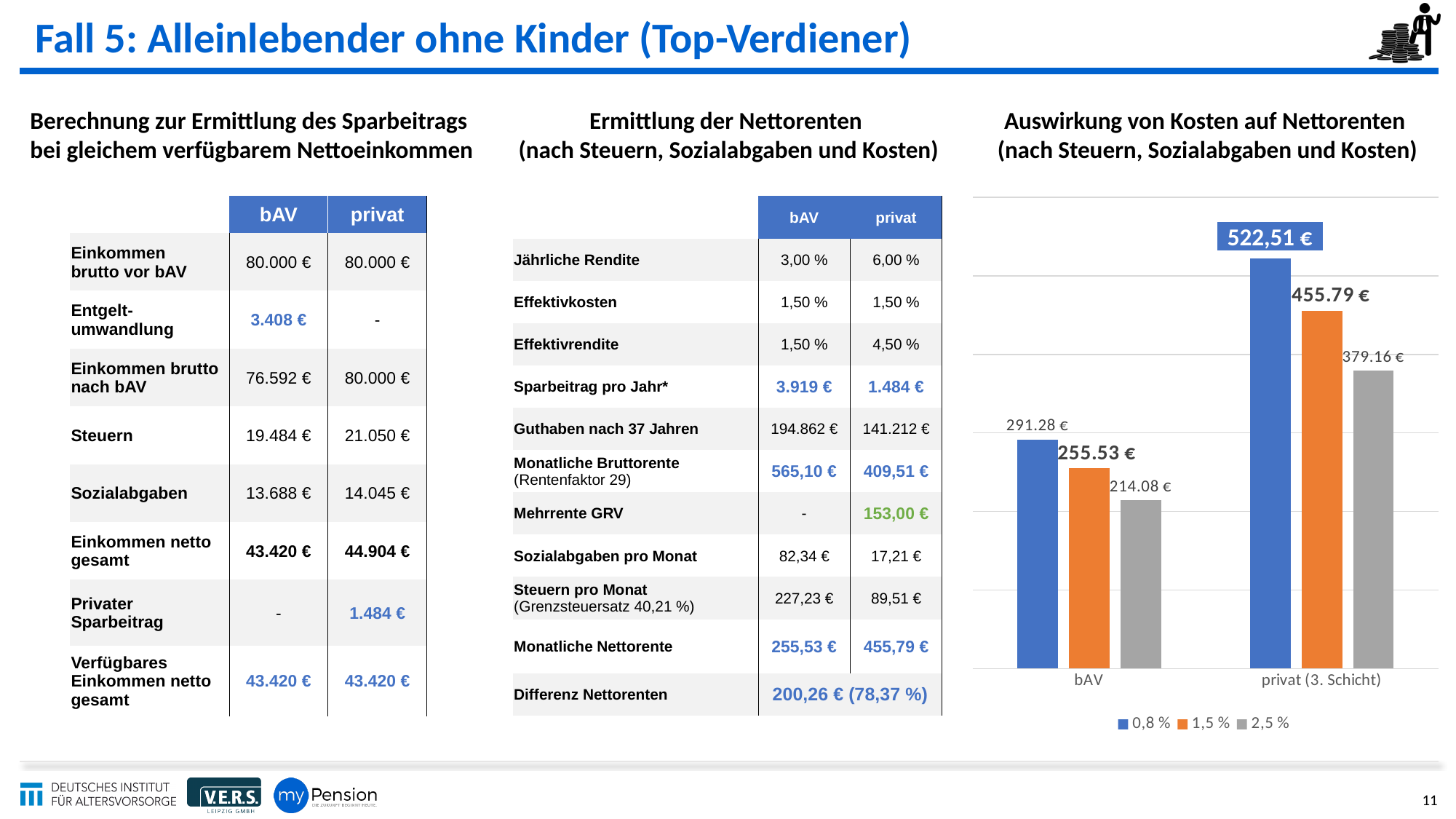
In the chart 'Auswirkung von Kosten auf Nettorenten', what is the value of the 1,5 % series for privat (3. Schicht)? 455.79 € In the chart 'Auswirkung von Kosten auf Nettorenten', which is larger: the 2,5 % value for privat (3. Schicht) or the 0,8 % value for bAV? 2,5 % value for privat (3. Schicht) How many categories are shown on the x axis of the chart 'Auswirkung von Kosten auf Nettorenten'? 2 In the chart 'Auswirkung von Kosten auf Nettorenten', what is the difference between the 1,5 % values for privat (3. Schicht) and bAV? 200.26 € How many series does the legend of the chart 'Auswirkung von Kosten auf Nettorenten' list? 3 In the chart 'Auswirkung von Kosten auf Nettorenten', which bar has the highest value? privat (3. Schicht), 0,8 % In the chart 'Auswirkung von Kosten auf Nettorenten', what is the value of the 0,8 % series for bAV? 291.28 € In the chart 'Auswirkung von Kosten auf Nettorenten', what is the difference between the 0,8 % and 2,5 % values for bAV? 77.20 € In the chart 'Auswirkung von Kosten auf Nettorenten', what is the value of the 2,5 % series for bAV? 214.08 € In the chart 'Auswirkung von Kosten auf Nettorenten', which bar has the lowest value? bAV, 2,5 % In the chart 'Auswirkung von Kosten auf Nettorenten', what is the value of the 0,8 % series for privat (3. Schicht)? 522,51 € What kind of chart is shown under the title 'Auswirkung von Kosten auf Nettorenten'? bar chart